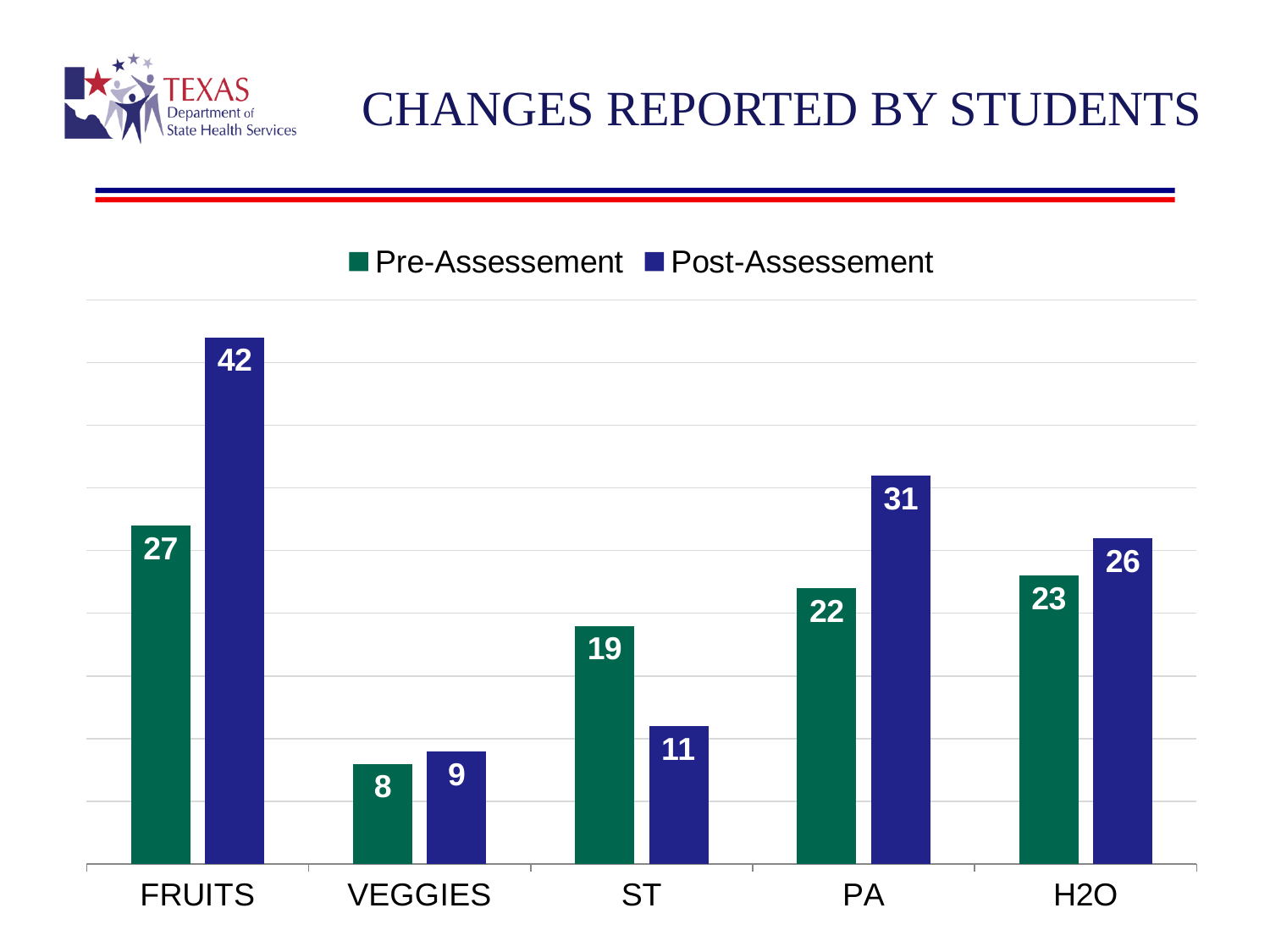
What kind of chart is shown on the slide? Bar chart How many series does the legend list? 2 What is the difference between the Pre-Assessement and Post-Assessement values for ST? 8 What is the Pre-Assessement value for ST? 19 How many categories are shown on the x axis? 5 Which category has the lowest Pre-Assessement value? VEGGIES What is the Post-Assessement value for H2O? 26 What is the difference between the Post-Assessement and Pre-Assessement values for PA? 9 What is the title of the slide? CHANGES REPORTED BY STUDENTS What is the Post-Assessement value for FRUITS? 42 Which is larger for VEGGIES, the Pre-Assessement value or the Post-Assessement value? Post-Assessement Which category has the highest Post-Assessement value? FRUITS